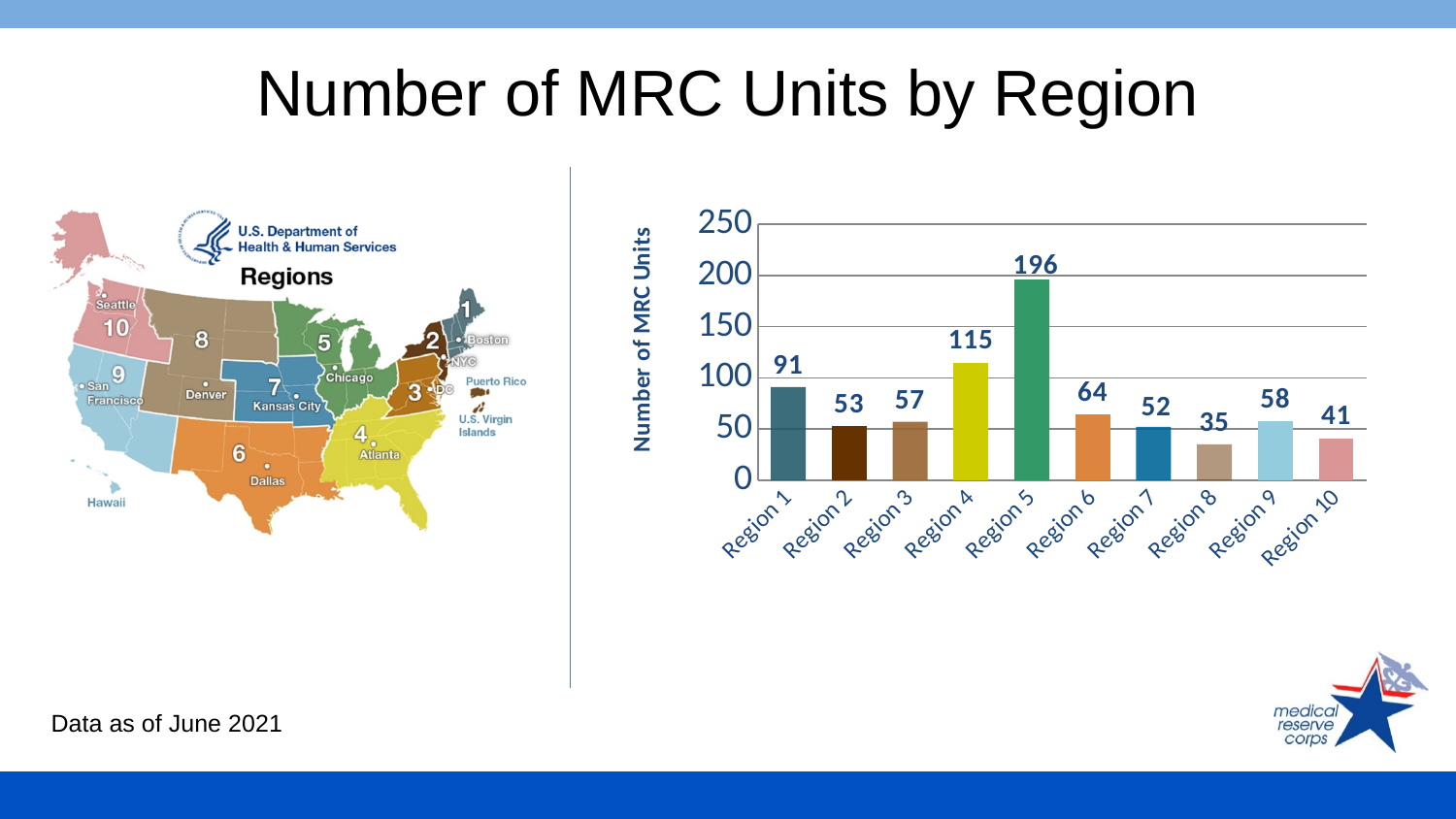
What is the difference in the number of MRC units between Region 1 and Region 10? 50 What is the number of MRC units for Region 8? 35 Which region has the lowest number of MRC units? Region 8 Which has more MRC units, Region 6 or Region 9? Region 6 What is the number of MRC units for Region 5? 196 What is the number of MRC units for Region 1? 91 What is the label of the vertical axis of the chart? Number of MRC Units What kind of chart is shown on the slide? Bar chart How many regions are shown on the chart? 10 What is the difference in the number of MRC units between Region 5 and Region 4? 81 Which region has the highest number of MRC units? Region 5 Is the value for Region 4 greater or less than 100? greater